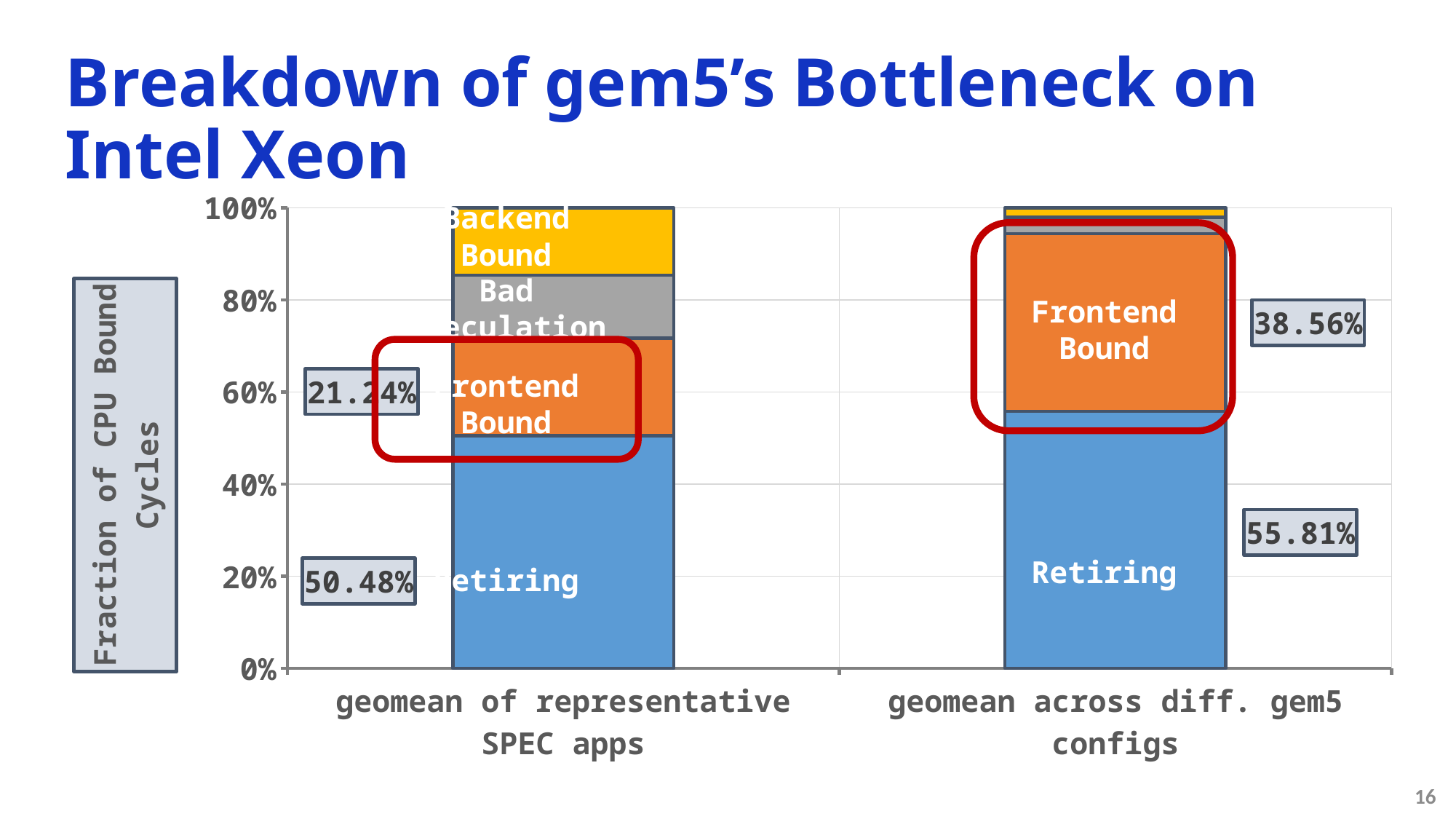
What is the Frontend Bound value for the geomean across diff. gem5 configs? 38.56% What is the Retiring value for the geomean of representative SPEC apps? 50.48% Which bar has the larger Retiring value, the SPEC apps or the gem5 configs? geomean across diff. gem5 configs What kind of chart is shown on the slide? Stacked bar chart What is the label on the y axis of the chart? Fraction of CPU Bound Cycles What is the difference between the Retiring values for the gem5 configs and the SPEC apps? 5.33 What is the Retiring value for the geomean across diff. gem5 configs? 55.81% Is the Bad Speculation value for the geomean of representative SPEC apps greater or less than 20%? less By how many percentage points does the Frontend Bound value for the gem5 configs exceed that for the SPEC apps? 17.32 What is the Frontend Bound value for the geomean of representative SPEC apps? 21.24% Which bar has the larger Frontend Bound value, the SPEC apps or the gem5 configs? geomean across diff. gem5 configs How many bars (categories) are shown on the x axis? 2